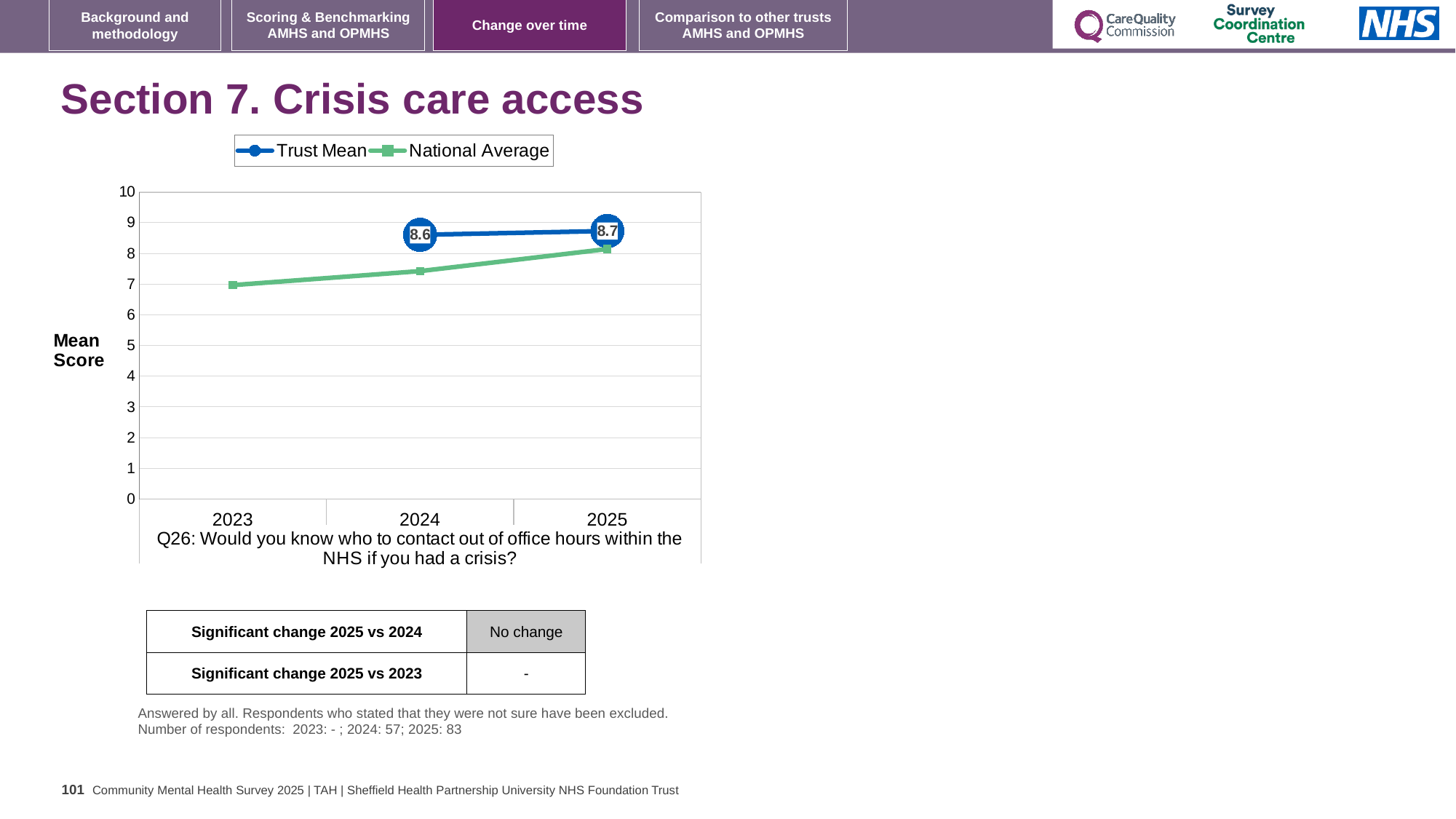
How many series does the legend list? 2 How many years are shown on the x axis? 3 In 2025, which is larger: the Trust Mean or the National Average? Trust Mean In which year is the Trust Mean highest? 2025 What kind of chart is shown on the slide? line chart Is the National Average value for 2025 greater or less than 7? greater Does the National Average rise or fall from 2023 to 2025? rise Is the National Average value for 2023 greater or less than 8? less What is the difference between the Trust Mean in 2025 and in 2024? 0.1 What is the Trust Mean value for 2024? 8.6 What is the label on the y axis of the chart? Mean Score What is the Trust Mean value for 2025? 8.7